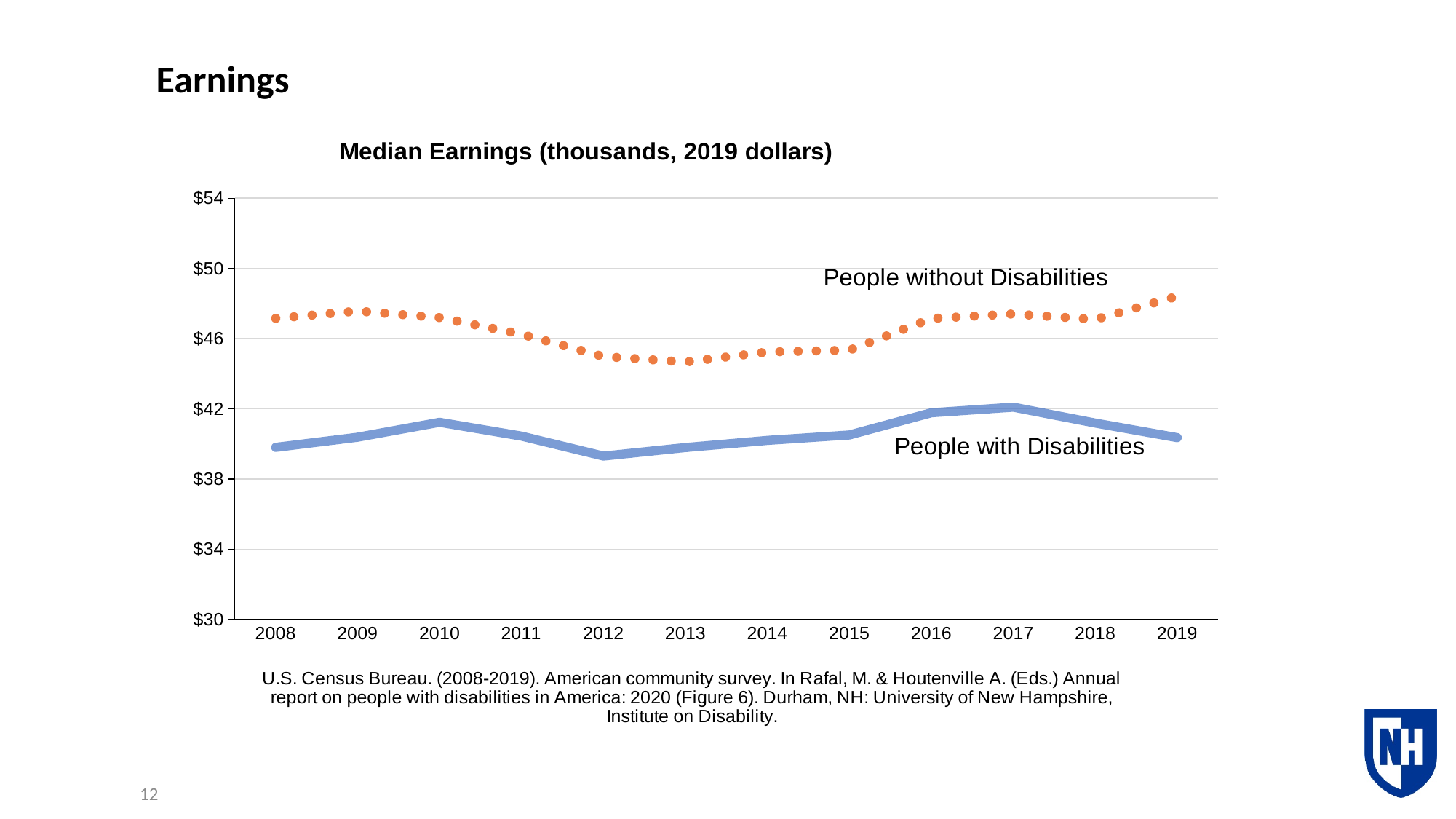
How many years are plotted along the x axis? 12 What is the title of the chart? Median Earnings (thousands, 2019 dollars) Is the value for People without Disabilities in 2013 greater or less than $46? less Is the value for People without Disabilities in 2019 greater or less than $46? greater Do the values for People without Disabilities rise or fall from 2009 to 2013? fall What kind of chart is shown on the slide? line chart Is the value for People with Disabilities in 2017 greater or less than $40? greater Which series is drawn as a dotted orange line? People without Disabilities In 2010, which series has the higher median earnings, People with Disabilities or People without Disabilities? People without Disabilities In which year is the value for People without Disabilities highest? 2019 How many series does the chart show? 2